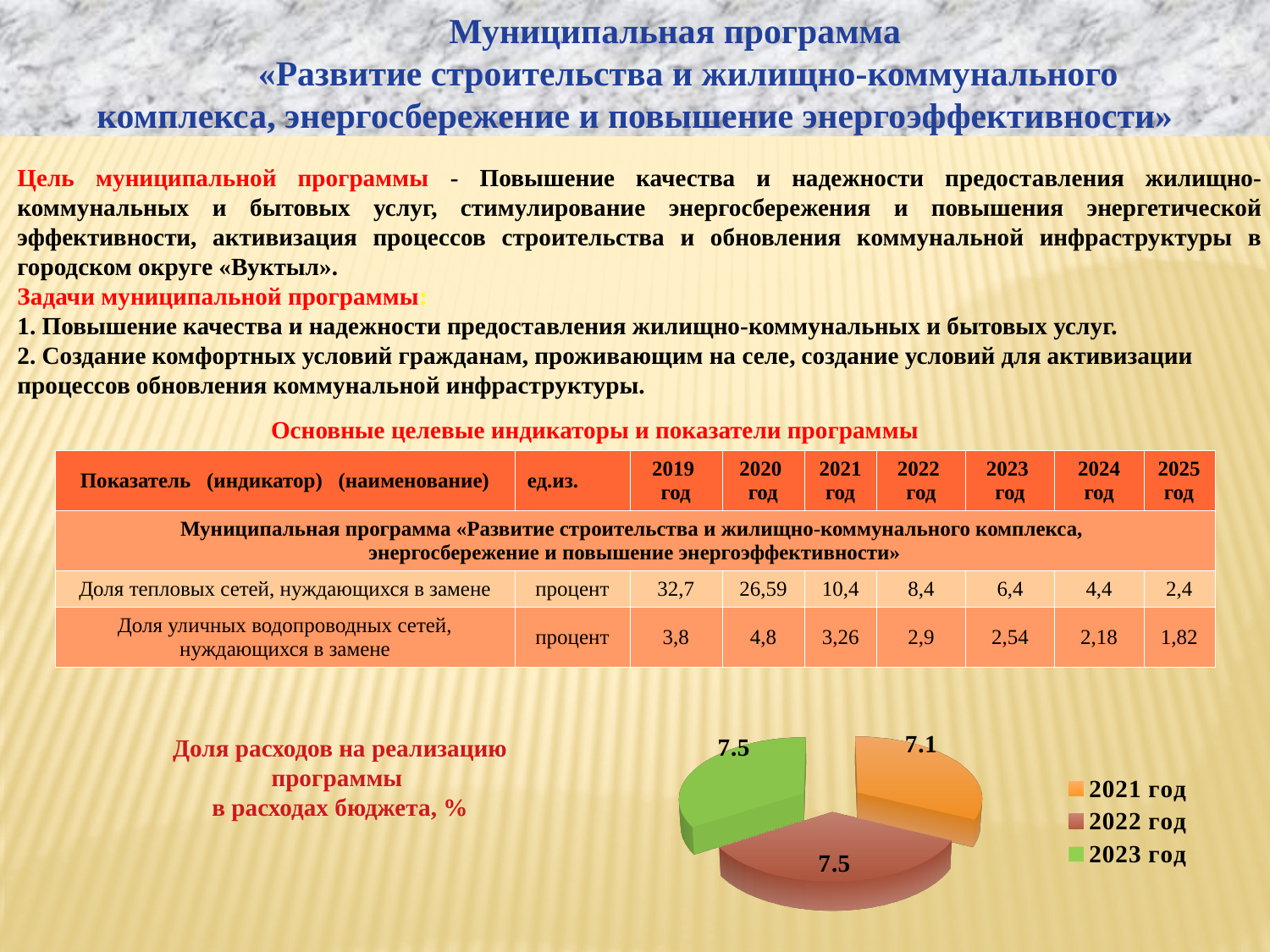
In the pie chart, what is the value for 2023 год? 7.5 What colour is the slice for 2023 год in the pie chart? green In the pie chart, what is the value for 2021 год? 7.1 What kind of chart is shown at the bottom of the slide? pie chart What is the title of the pie chart? Доля расходов на реализацию программы в расходах бюджета, % In the pie chart, which is larger: the value for 2021 год or the value for 2022 год? 2022 год In the pie chart, what is the value for 2022 год? 7.5 In the pie chart, what is the difference between the value for 2023 год and the value for 2021 год? 0.4 How many slices does the pie chart have? 3 How many entries does the pie chart's legend list? 3 Which year has the smallest slice in the pie chart? 2021 год